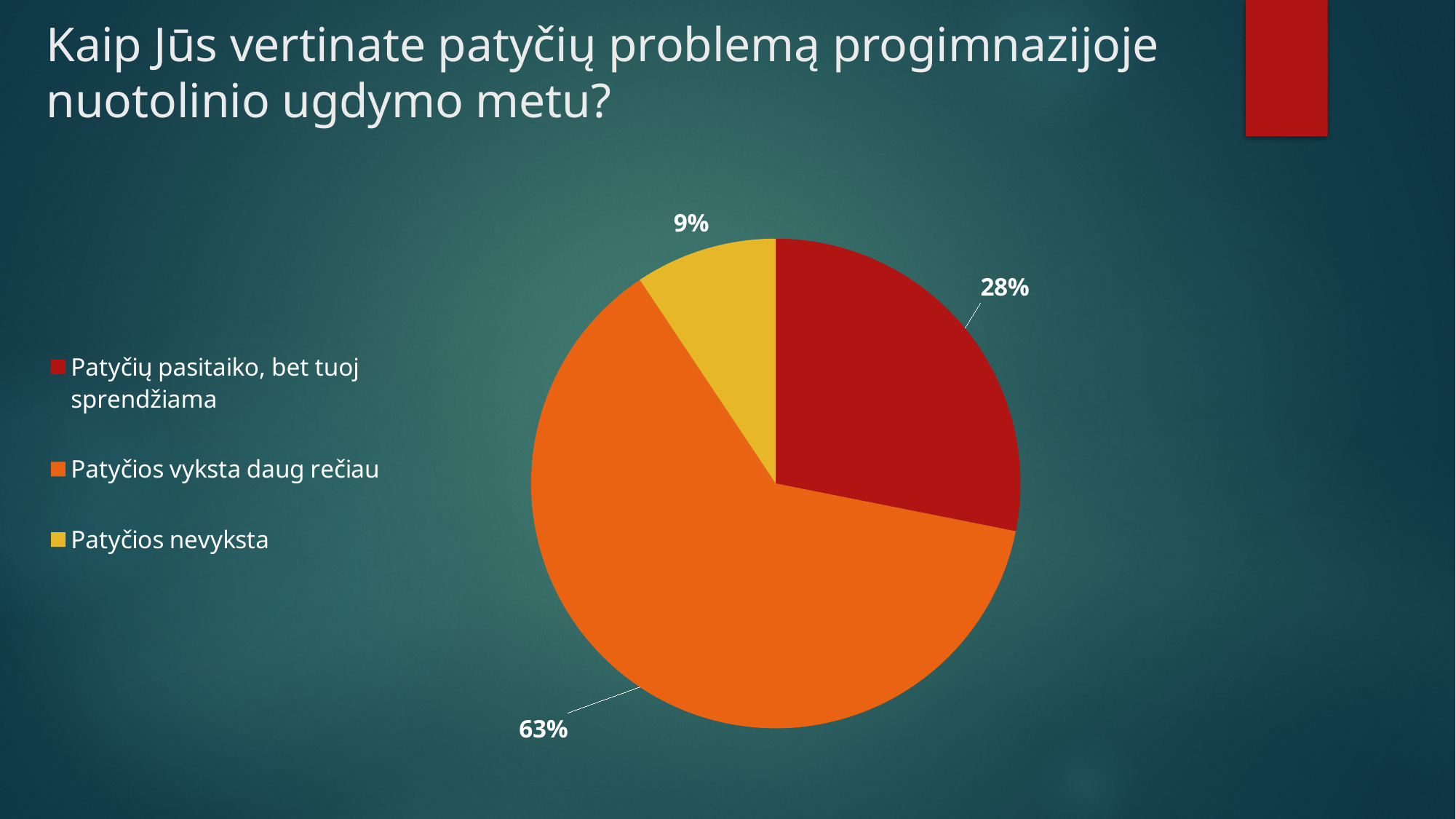
What kind of chart is shown on the slide? pie chart What is the difference between the shares of "Patyčių pasitaiko, bet tuoj sprendžiama" and "Patyčios nevyksta"? 19% Which category has the largest slice of the pie? Patyčios vyksta daug rečiau What share of the pie does "Patyčios nevyksta" have? 9% What share of the pie does "Patyčių pasitaiko, bet tuoj sprendžiama" have? 28% What share of the pie does "Patyčios vyksta daug rečiau" have? 63% How many categories does the pie chart have? 3 What colour is the slice for "Patyčios nevyksta"? yellow What is the difference between the shares of "Patyčios vyksta daug rečiau" and "Patyčių pasitaiko, bet tuoj sprendžiama"? 35% Which is larger: the share for "Patyčių pasitaiko, bet tuoj sprendžiama" or the share for "Patyčios nevyksta"? Patyčių pasitaiko, bet tuoj sprendžiama What is the title of the slide containing the chart? Kaip Jūs vertinate patyčių problemą progimnazijoje nuotolinio ugdymo metu? Which category has the smallest slice of the pie? Patyčios nevyksta